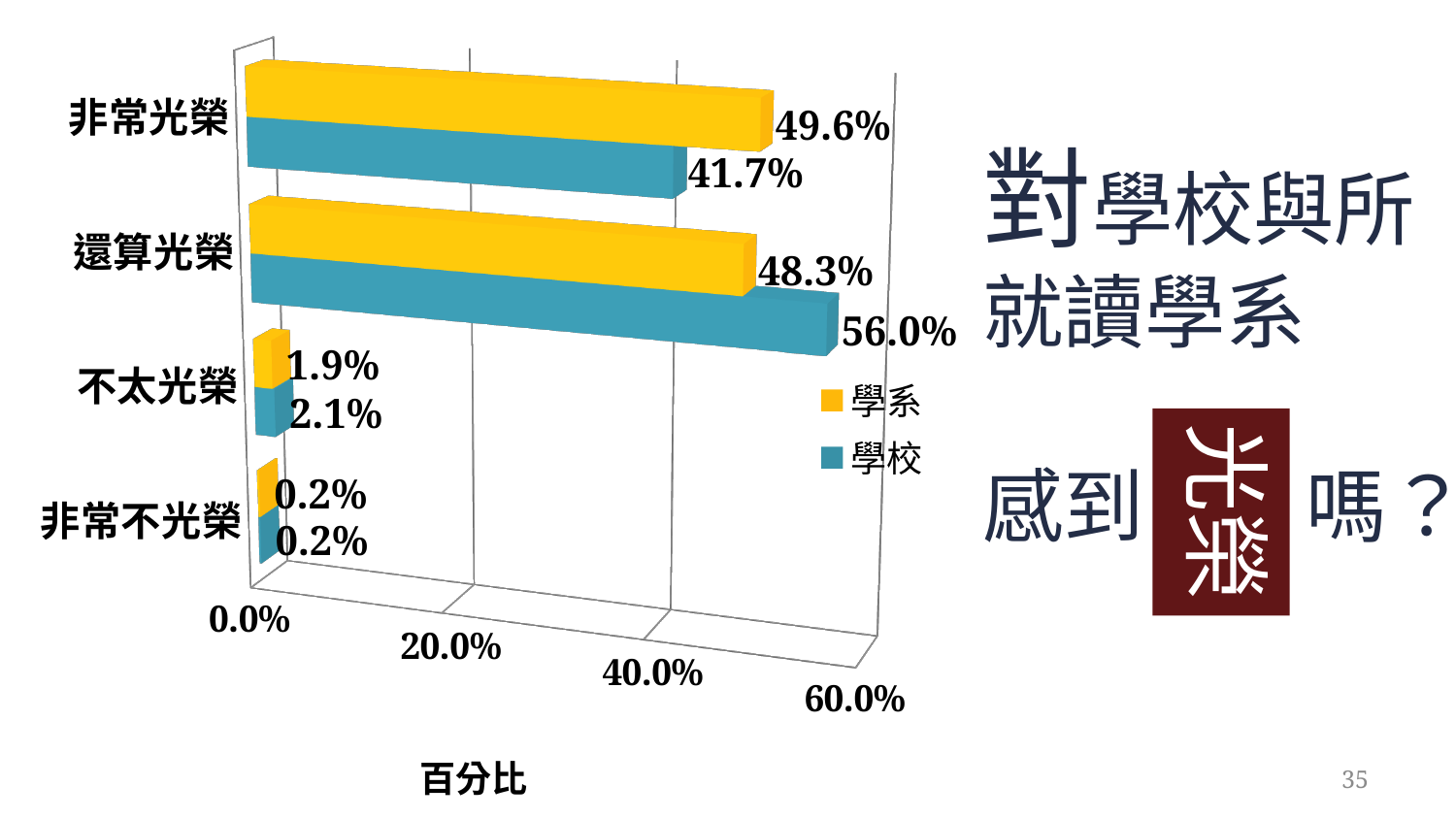
Which category has the highest value for the 學校 series? 還算光榮 What is the value for 學系 in the 非常光榮 category? 49.6% What kind of chart is shown on the slide? Bar chart What is the label of the horizontal axis? 百分比 What is the difference between the 學校 and 學系 values in the 還算光榮 category? 7.7% What is the value for 學系 in the 非常不光榮 category? 0.2% What is the value for 學校 in the 還算光榮 category? 56.0% How many categories are shown on the chart? 4 How many series does the legend list? 2 Which category has the lowest value for the 學系 series? 非常不光榮 In the 非常光榮 category, which series has the larger value, 學系 or 學校? 學系 What is the value for 學校 in the 不太光榮 category? 2.1%